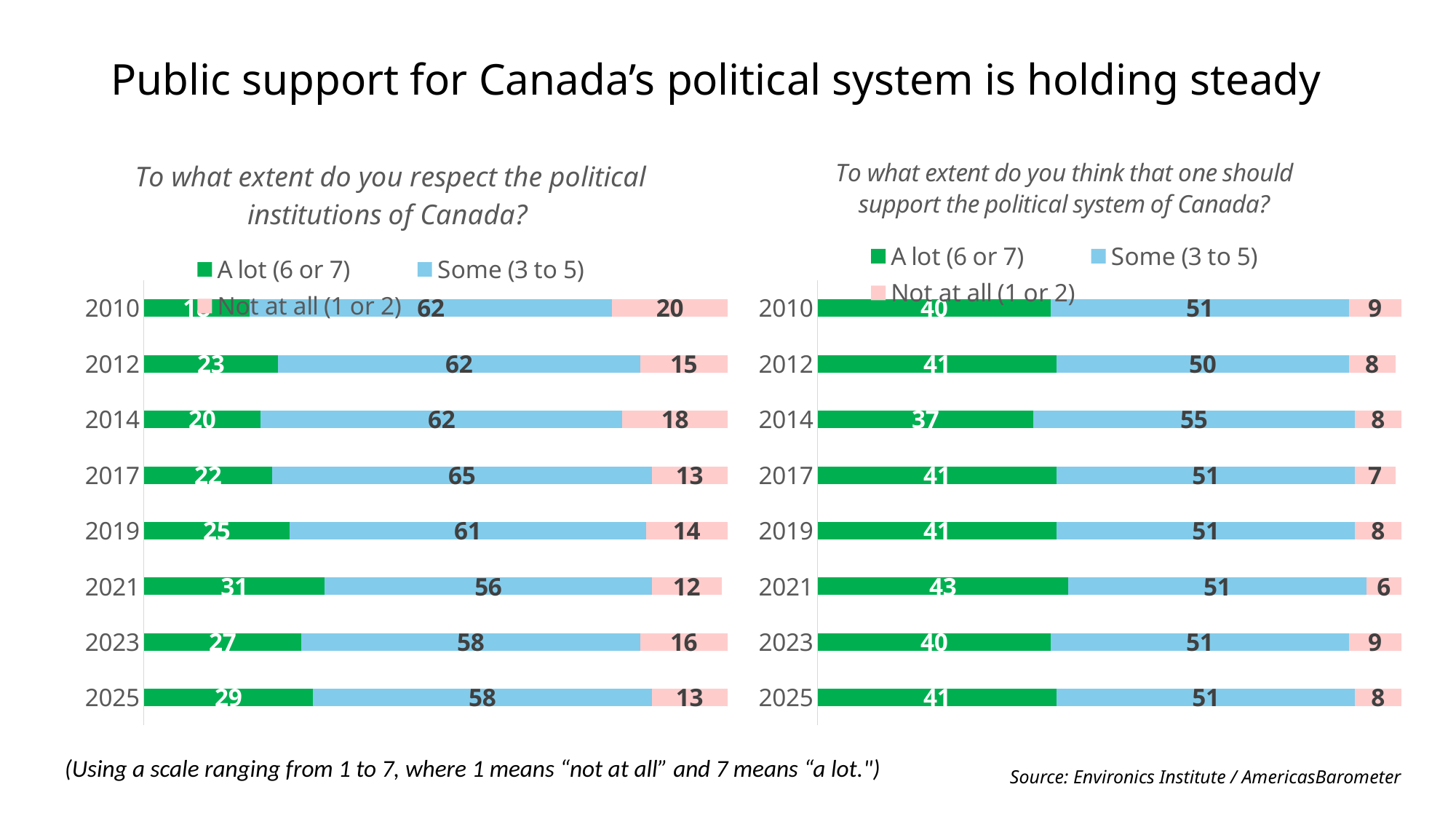
In the left chart (respect the political institutions of Canada), what is the total of the stacked bar for 2019? 100 In the right chart (one should support the political system of Canada), which year has the lowest value for 'A lot (6 or 7)'? 2014 In the left chart (respect the political institutions of Canada), which year has the highest value for 'Some (3 to 5)'? 2017 How many years are shown in the right chart (one should support the political system of Canada)? 8 What type of chart is used on the right (one should support the political system of Canada)? Stacked bar chart In the right chart (one should support the political system of Canada), which year has the highest value for 'A lot (6 or 7)'? 2021 How many series does the legend of the left chart (respect the political institutions of Canada) list? 3 In the left chart (respect the political institutions of Canada), what is the value for 'Not at all (1 or 2)' in 2010? 20 In the right chart (one should support the political system of Canada), is the 'Not at all (1 or 2)' value larger in 2010 or in 2021? 2010 In the left chart (respect the political institutions of Canada), what is the value for 'A lot (6 or 7)' in 2021? 31 In the right chart (one should support the political system of Canada), what is the value for 'Some (3 to 5)' in 2014? 55 In the left chart (respect the political institutions of Canada), what is the difference between the 'A lot (6 or 7)' values for 2025 and 2012? 6